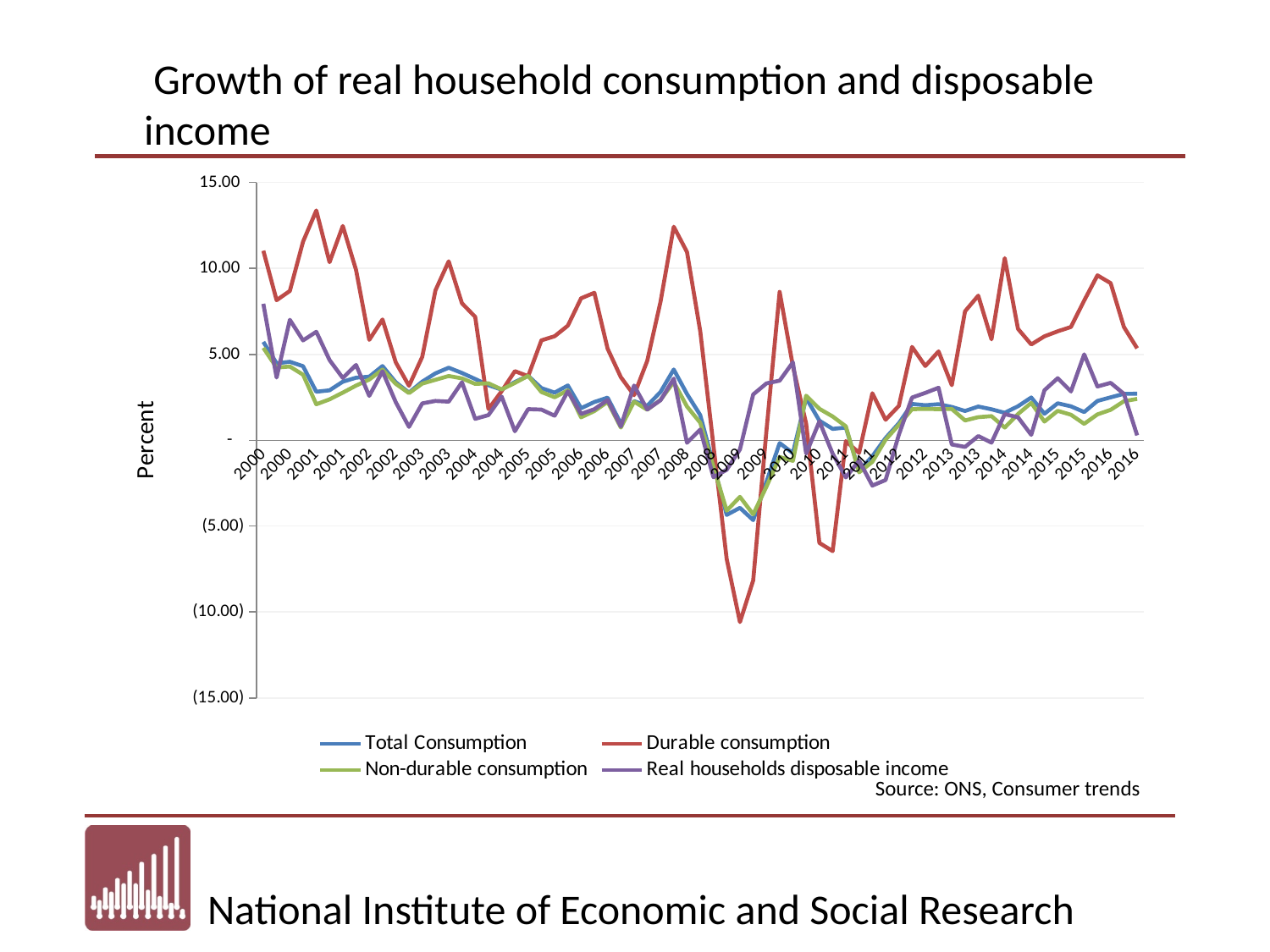
At the 2009 trough, which is lower: Durable consumption or Total Consumption? Durable consumption What is the title of the chart? Growth of real household consumption and disposable income Is the peak value of Durable consumption in 2014 greater or less than 5.00? greater Which series reaches the lowest value anywhere on the chart? Durable consumption Is the lowest value of Durable consumption in 2009 greater or less than (5.00)? less How many series does the legend list? 4 Does Durable consumption rise or fall between its 2008 peak and its 2009 trough? fall Is the lowest value of Total Consumption in 2009 greater or less than 0? less What kind of chart is shown on the slide? line chart Which series reaches the highest value anywhere on the chart? Durable consumption What is the label on the vertical axis? Percent